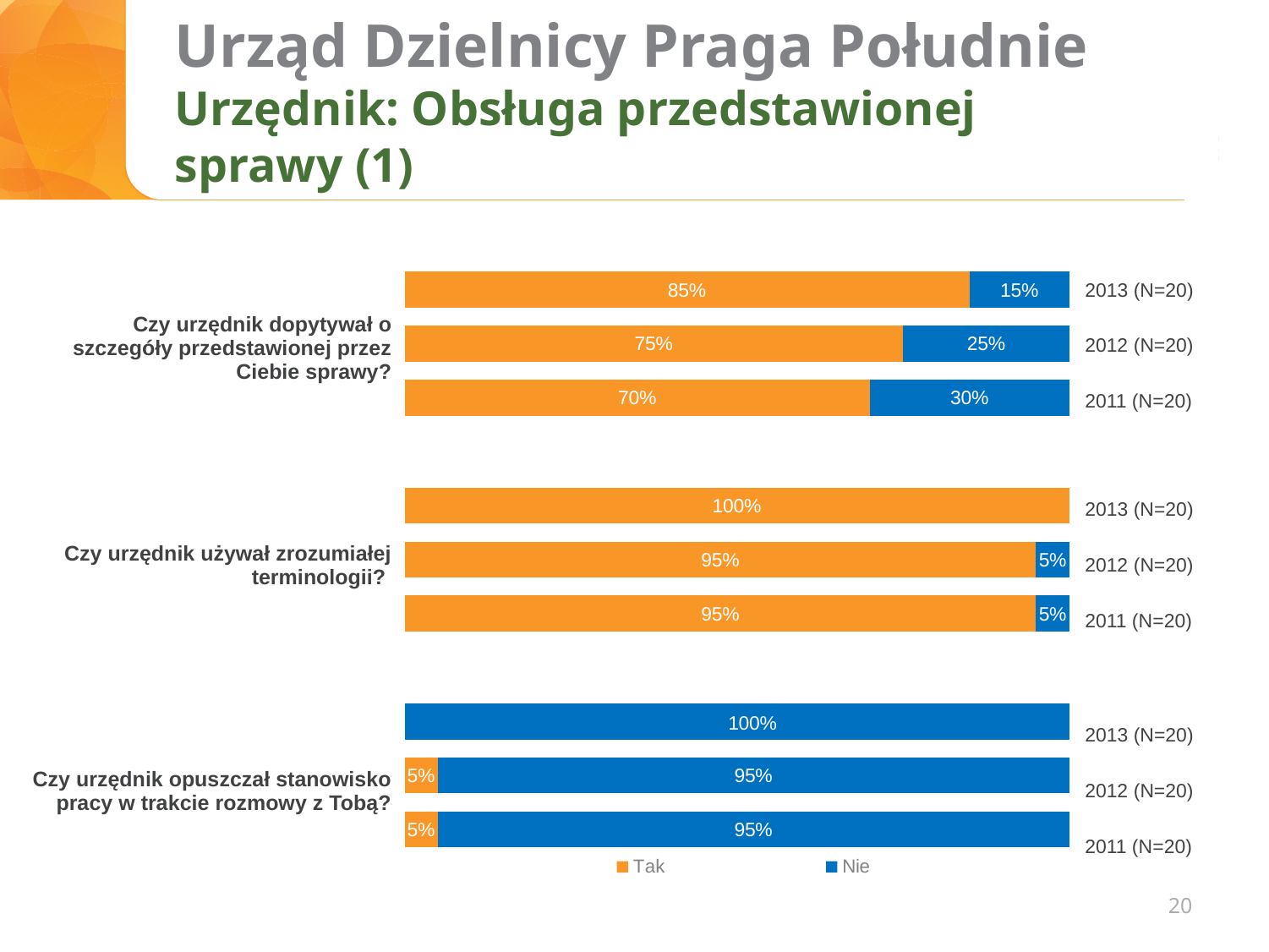
What percentage answered "Nie" in 2011 to the question "Czy urzędnik dopytywał o szczegóły przedstawionej przez Ciebie sprawy?"? 30% For the question "Czy urzędnik dopytywał o szczegóły przedstawionej przez Ciebie sprawy?", what is the difference between the "Tak" share in 2013 and in 2011? 15 percentage points How many series does the legend list? 2 Which colour represents the "Nie" answers in the chart? blue For the question "Czy urzędnik dopytywał o szczegóły przedstawionej przez Ciebie sprawy?", which year has the lowest "Tak" share? 2011 What percentage answered "Nie" in 2012 to the question "Czy urzędnik opuszczał stanowisko pracy w trakcie rozmowy z Tobą?"? 95% For the question "Czy urzędnik używał zrozumiałej terminologii?", is the "Tak" share in 2012 larger or smaller than in 2013? smaller What type of chart is shown on the slide? stacked bar chart What percentage answered "Tak" in 2013 to the question "Czy urzędnik dopytywał o szczegóły przedstawionej przez Ciebie sprawy?"? 85% For the question "Czy urzędnik dopytywał o szczegóły przedstawionej przez Ciebie sprawy?", which year has the highest "Tak" share? 2013 For the question "Czy urzędnik dopytywał o szczegóły przedstawionej przez Ciebie sprawy?", does the "Tak" share rise or fall from 2011 to 2013? rise What percentage answered "Tak" in 2013 to the question "Czy urzędnik używał zrozumiałej terminologii?"? 100%